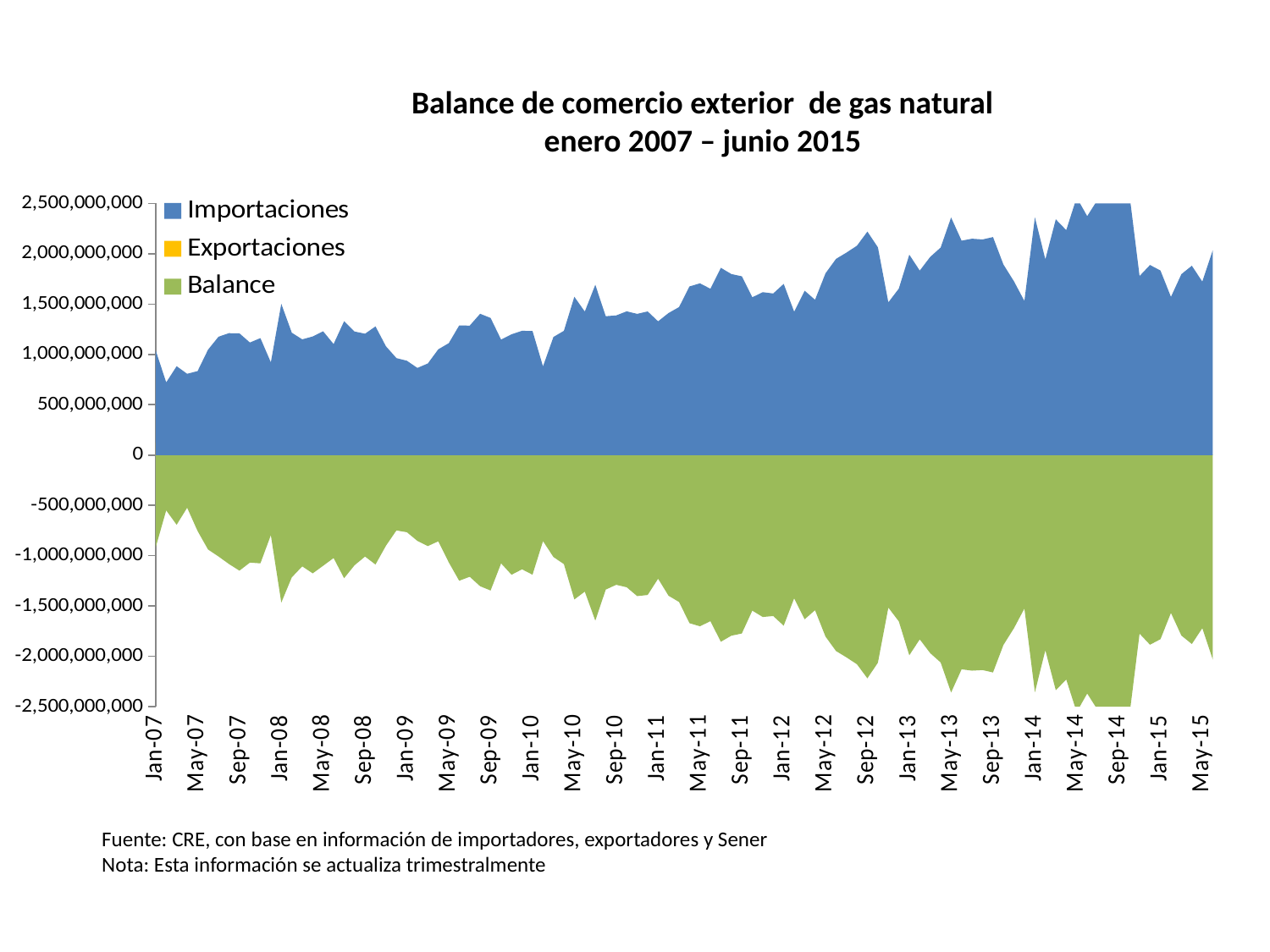
How many series does the legend list? 3 Is the Importaciones value at Sep-14 greater or less than 2,000,000,000? greater Which is larger, the Importaciones value at Sep-14 or the Importaciones value at Jan-09? Sep-14 Is the Balance value at Jan-09 greater or less than -1,000,000,000? greater Overall, does the Balance series become more negative or less negative from Jan-07 to May-15? more negative What are the three series named in the legend? Importaciones, Exportaciones, Balance What kind of chart is shown on the slide? area chart Is the Importaciones value at May-13 greater or less than 2,000,000,000? greater Overall, do the Importaciones values rise or fall from Jan-07 to May-15? rise What is the title of the chart? Balance de comercio exterior de gas natural enero 2007 – junio 2015